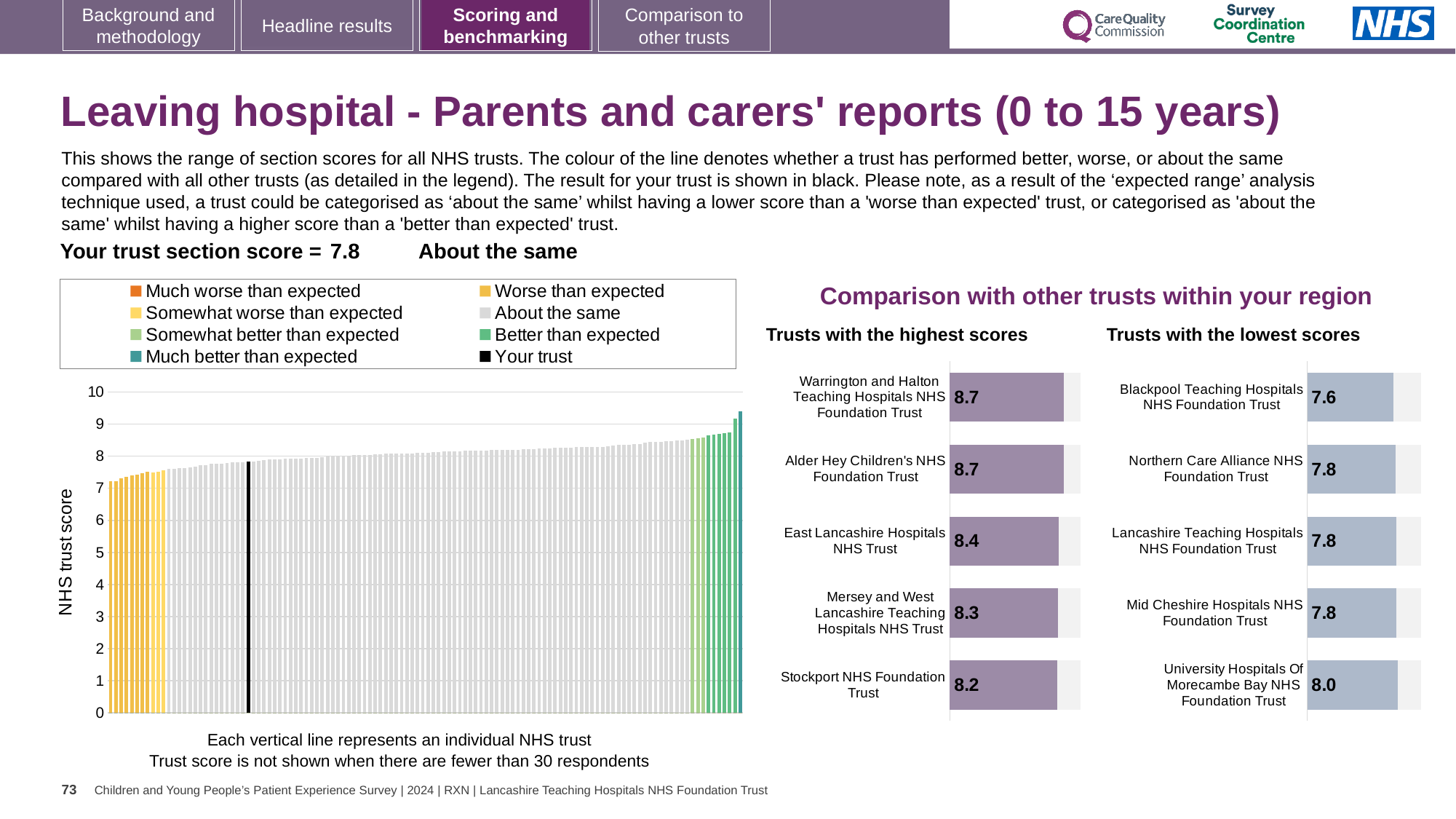
In the 'Trusts with the highest scores' chart, what is the score for East Lancashire Hospitals NHS Trust? 8.4 In the 'Trusts with the highest scores' chart, which has the higher score: East Lancashire Hospitals NHS Trust or Mersey and West Lancashire Teaching Hospitals NHS Trust? East Lancashire Hospitals NHS Trust In the 'Trusts with the lowest scores' chart, which trust has the highest score? University Hospitals Of Morecambe Bay NHS Foundation Trust In the 'Trusts with the highest scores' chart, which trust has the lowest score? Stockport NHS Foundation Trust How many entries does the legend above the main chart on the left list? 8 In the 'Trusts with the lowest scores' chart, what is the score for Blackpool Teaching Hospitals NHS Foundation Trust? 7.6 How many trusts are shown in the 'Trusts with the lowest scores' chart? 5 In the 'Trusts with the lowest scores' chart, what is the difference between the scores of University Hospitals Of Morecambe Bay NHS Foundation Trust and Blackpool Teaching Hospitals NHS Foundation Trust? 0.4 In the 'Trusts with the highest scores' chart, what is the difference between the scores of Warrington and Halton Teaching Hospitals NHS Foundation Trust and Stockport NHS Foundation Trust? 0.5 What kind of chart is the main chart on the left with the y-axis labelled 'NHS trust score'? Bar chart In the main chart on the left, do the trust scores rise or fall from left to right along the x axis? Rise In the main chart on the left, is the value of the tallest bar at the far right greater or less than 9? greater